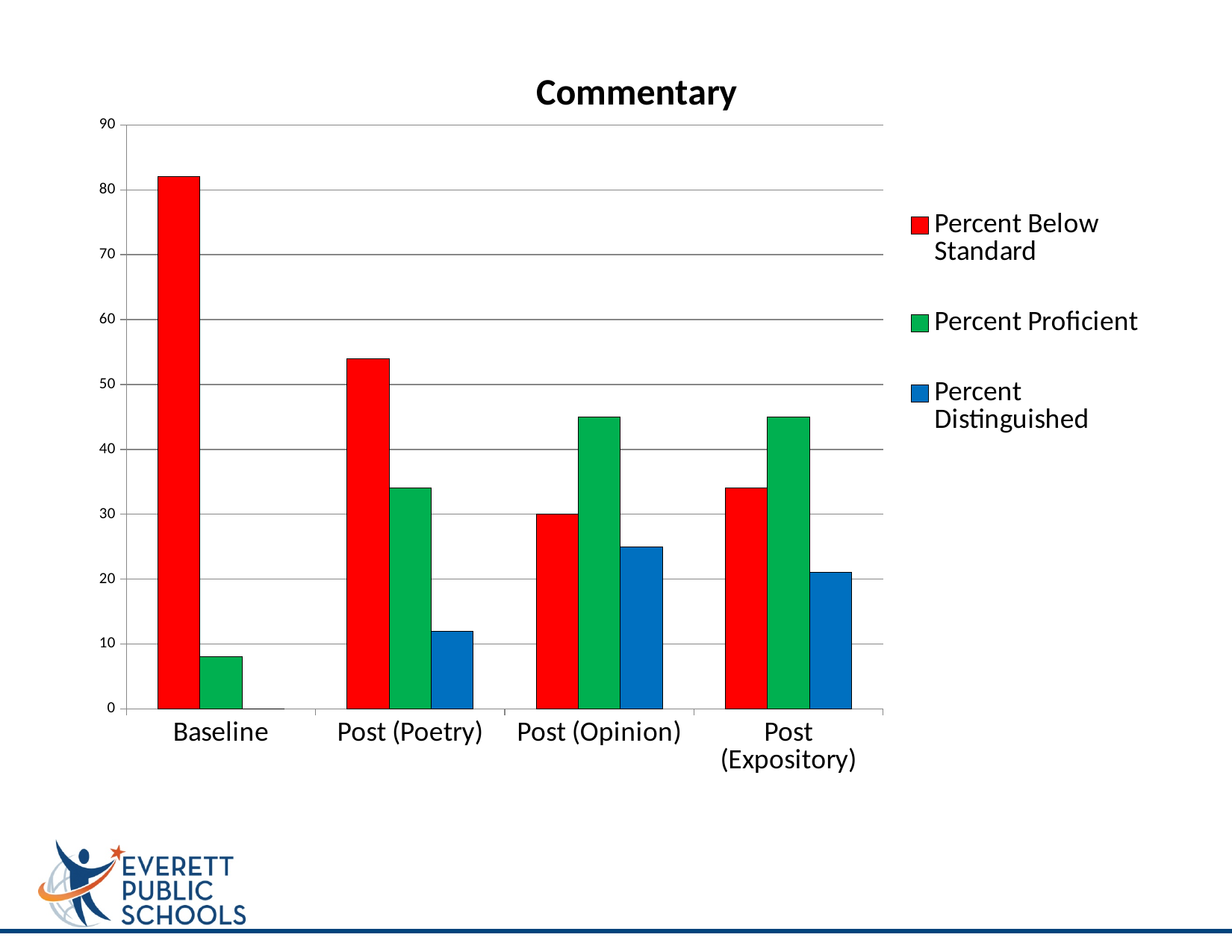
How many series does the legend list? 3 How many categories are shown on the x axis of the chart? 4 Is the Percent Distinguished value for Post (Poetry) greater or less than 20? less Is the Percent Below Standard value for Baseline greater or less than 70? greater Does Percent Below Standard rise or fall from Baseline to Post (Poetry) to Post (Opinion)? fall Is the Percent Below Standard value for Post (Poetry) greater or less than 50? greater What is the title of the chart? Commentary In which category is Percent Below Standard the highest? Baseline In which category is Percent Distinguished the lowest? Baseline For Post (Opinion), which is larger: Percent Proficient or Percent Below Standard? Percent Proficient What kind of chart is shown on the slide? Bar chart